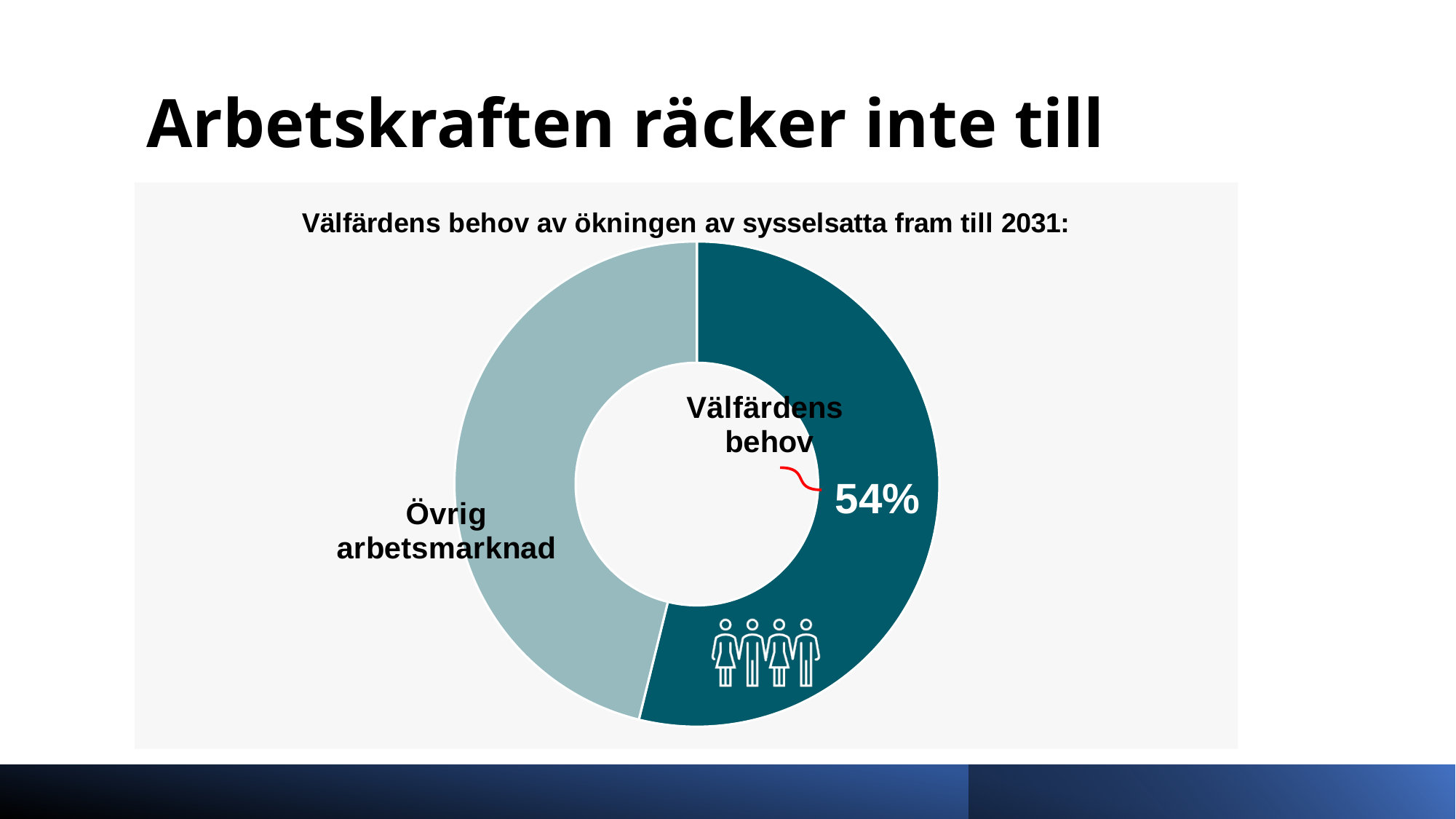
What percentage is shown for the Välfärdens behov slice? 54% Which slice of the chart is the smallest? Övrig arbetsmarknad What share of the chart does Välfärdens behov account for? 54% Which is larger, Välfärdens behov or Övrig arbetsmarknad? Välfärdens behov What kind of chart is shown on the slide? Pie chart (donut) What is the title of the chart? Välfärdens behov av ökningen av sysselsatta fram till 2031: Which slice of the chart is the largest? Välfärdens behov Which slice is drawn in the darker teal colour? Välfärdens behov Is the share for Välfärdens behov greater or less than 50%? greater How many slices does the chart have? 2